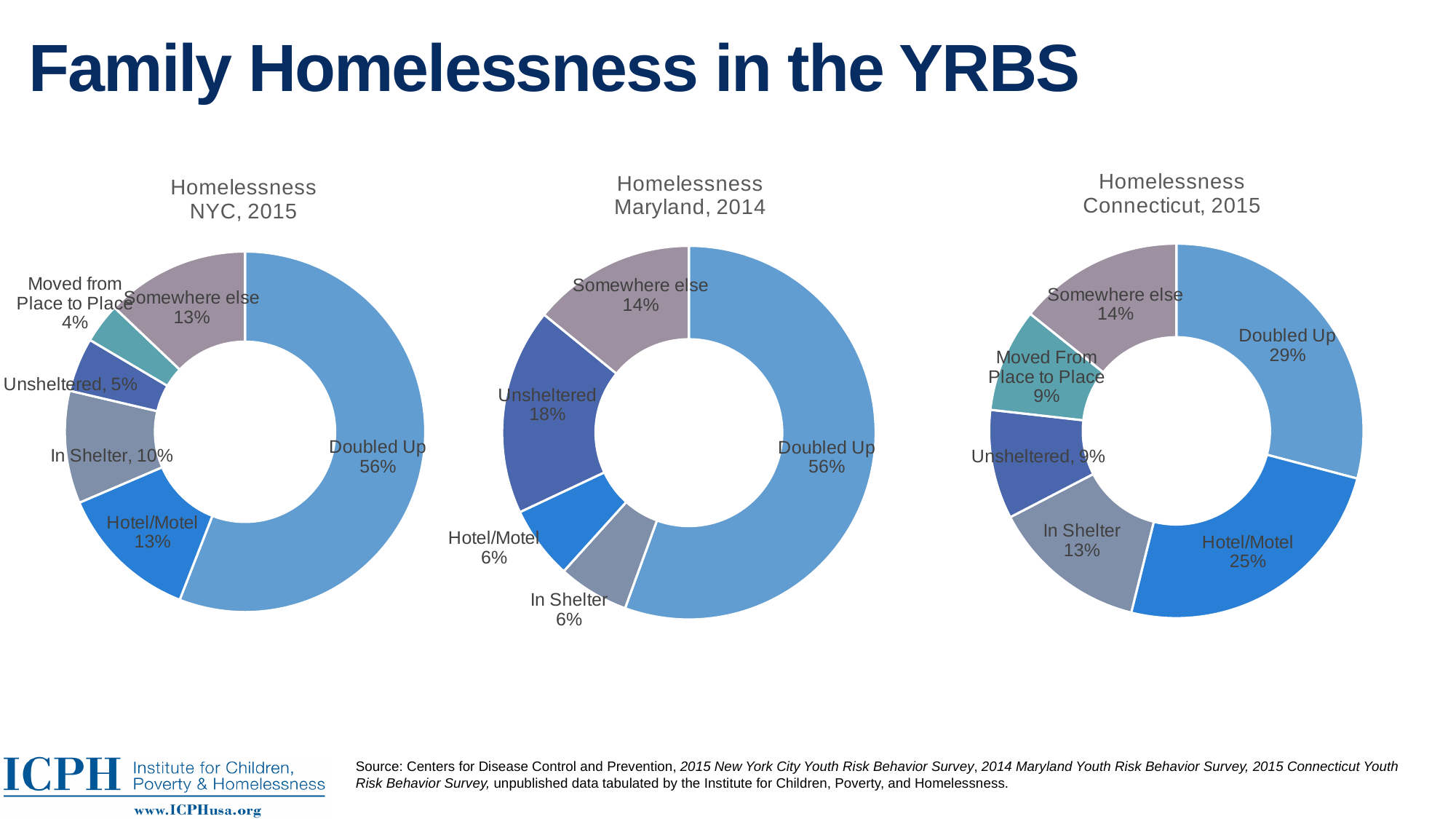
In the Homelessness Connecticut, 2015 chart, which is larger: In Shelter or Unsheltered? In Shelter How many categories are shown in the Homelessness NYC, 2015 chart? 6 In the Homelessness NYC, 2015 chart, what is the combined share of Hotel/Motel and In Shelter? 23% What type of chart is used for Homelessness NYC, 2015? Doughnut (pie) chart How many charts are shown on the slide? 3 In the Homelessness Connecticut, 2015 chart, which category has the largest share? Doubled Up In the Homelessness Maryland, 2014 chart, what share is Unsheltered? 18% In the Homelessness Maryland, 2014 chart, what is the difference between the Doubled Up share and the Unsheltered share? 38 percentage points In the Homelessness NYC, 2015 chart, what share is Doubled Up? 56% In the Homelessness Connecticut, 2015 chart, what share is Hotel/Motel? 25% How many categories are shown in the Homelessness Maryland, 2014 chart? 5 In the Homelessness NYC, 2015 chart, which category has the smallest share? Moved from Place to Place